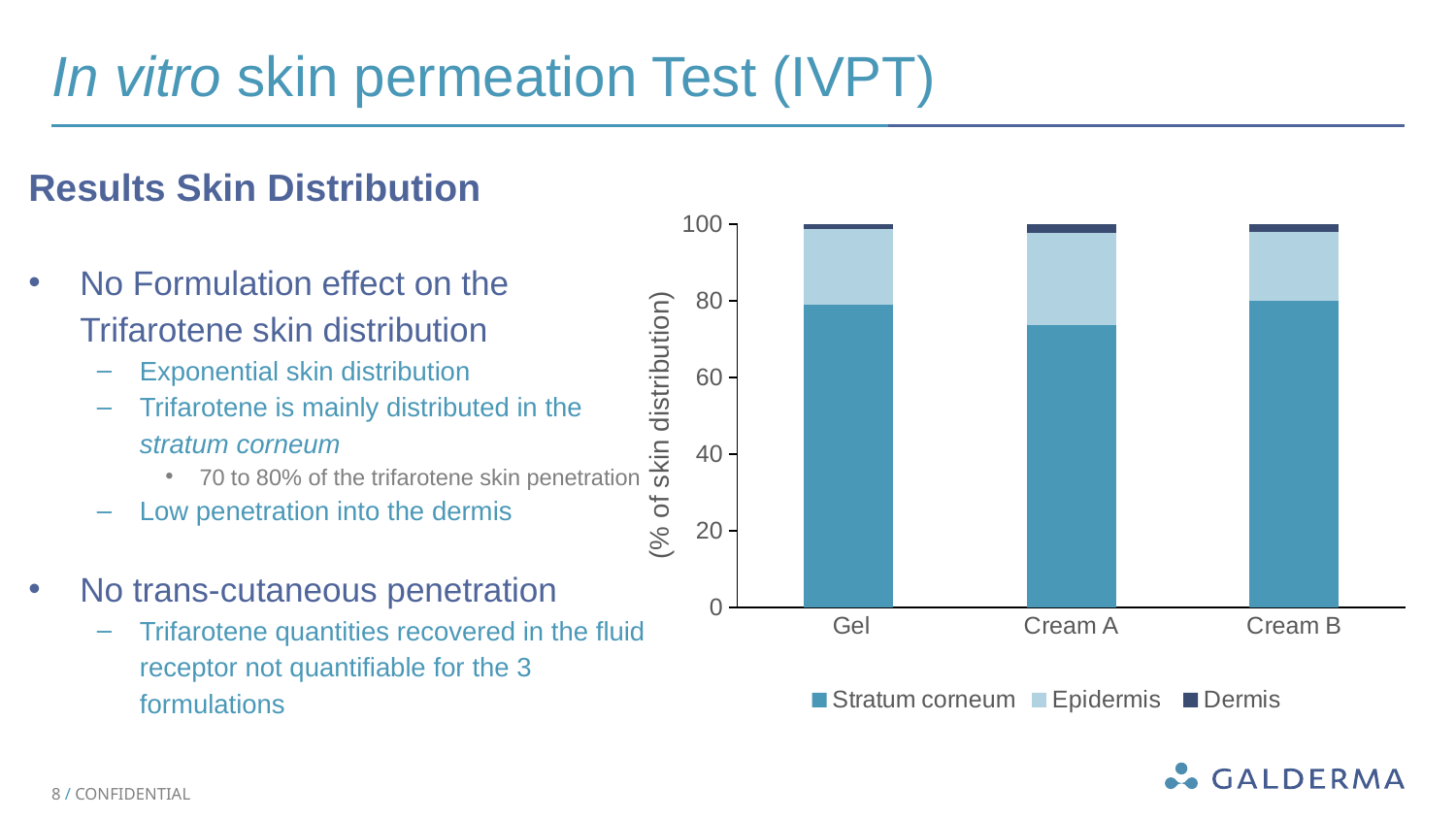
What is the label of the y axis of the chart? (% of skin distribution) Which series makes up the largest part of each stacked bar? Stratum corneum Which formulation has the lowest Stratum corneum value? Cream A Is the Stratum corneum value for Cream A greater or less than 80? less How many formulations (categories) are shown on the x axis of the chart? 3 Is the Stratum corneum value for Cream B greater or less than 60? greater Which series is shown in the darkest blue at the top of each bar? Dermis Which formulation has the largest Epidermis segment? Cream A How many series does the chart legend list? 3 What kind of chart is shown on the slide? Stacked bar chart Which is larger, the Stratum corneum value for Gel or for Cream A? Gel Is the Stratum corneum value for Gel greater or less than 60? greater